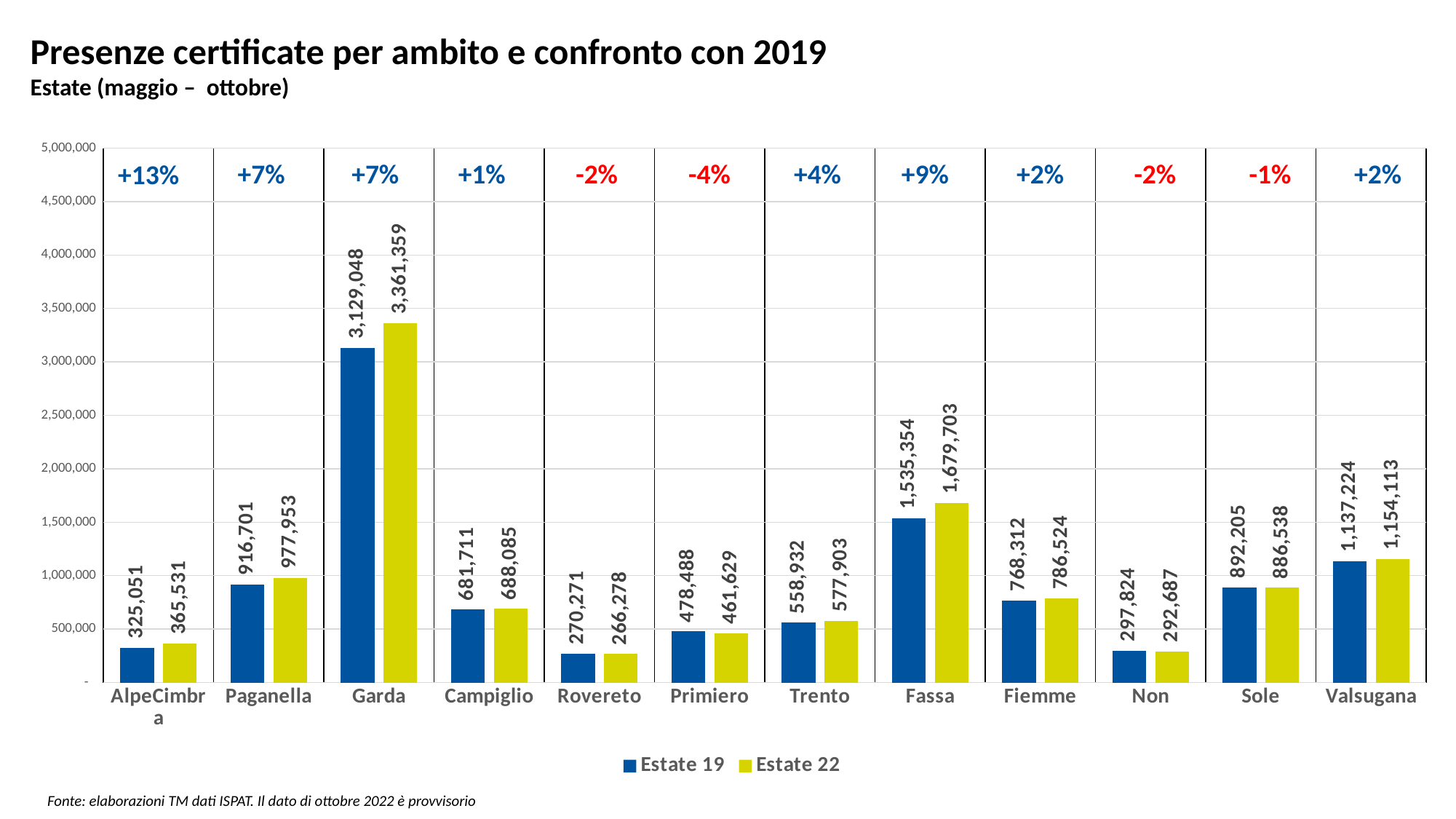
Which is larger for Sole: the Estate 19 value or the Estate 22 value? Estate 19 How many categories (ambiti) are shown on the x axis? 12 How many series does the legend list? 2 What is the Estate 22 value for Garda? 3,361,359 What percentage change is shown above the bars for Primiero? -4% What is the Estate 22 value for AlpeCimbra? 365,531 What is the title of the chart? Presenze certificate per ambito e confronto con 2019 What is the difference between the Estate 22 and Estate 19 values for Paganella? 61,252 What is the Estate 19 value for Fassa? 1,535,354 What kind of chart is shown on the slide? Bar chart Which category has the lowest Estate 19 value? Rovereto Which category has the highest Estate 22 value? Garda